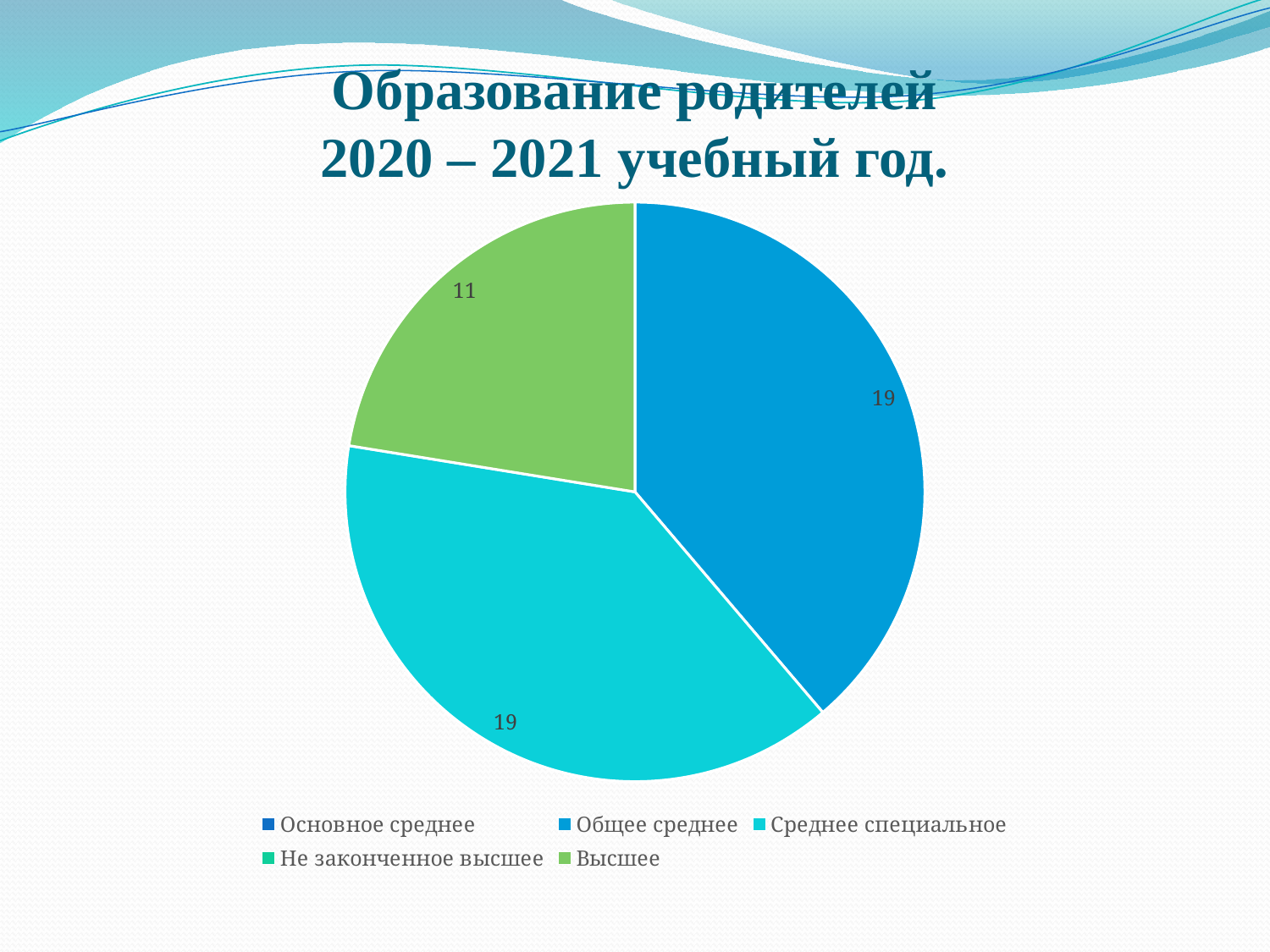
What kind of chart is shown on the slide? pie chart What is the value shown for the Высшее slice? 11 How many entries does the legend list? 5 What is the value shown for the Среднее специальное slice? 19 What is the title of the chart on the slide? Образование родителей 2020 – 2021 учебный год. Which is larger, the Общее среднее slice or the Высшее slice? Общее среднее What is the value shown for the Общее среднее slice? 19 What is the total of the three labelled slice values? 49 What is the difference between the Общее среднее value and the Высшее value? 8 How many slices with data labels are visible in the pie? 3 Are the Общее среднее and Среднее специальное slices equal in value? Yes, both are 19 Which of the labelled slices in the pie is the smallest? Высшее